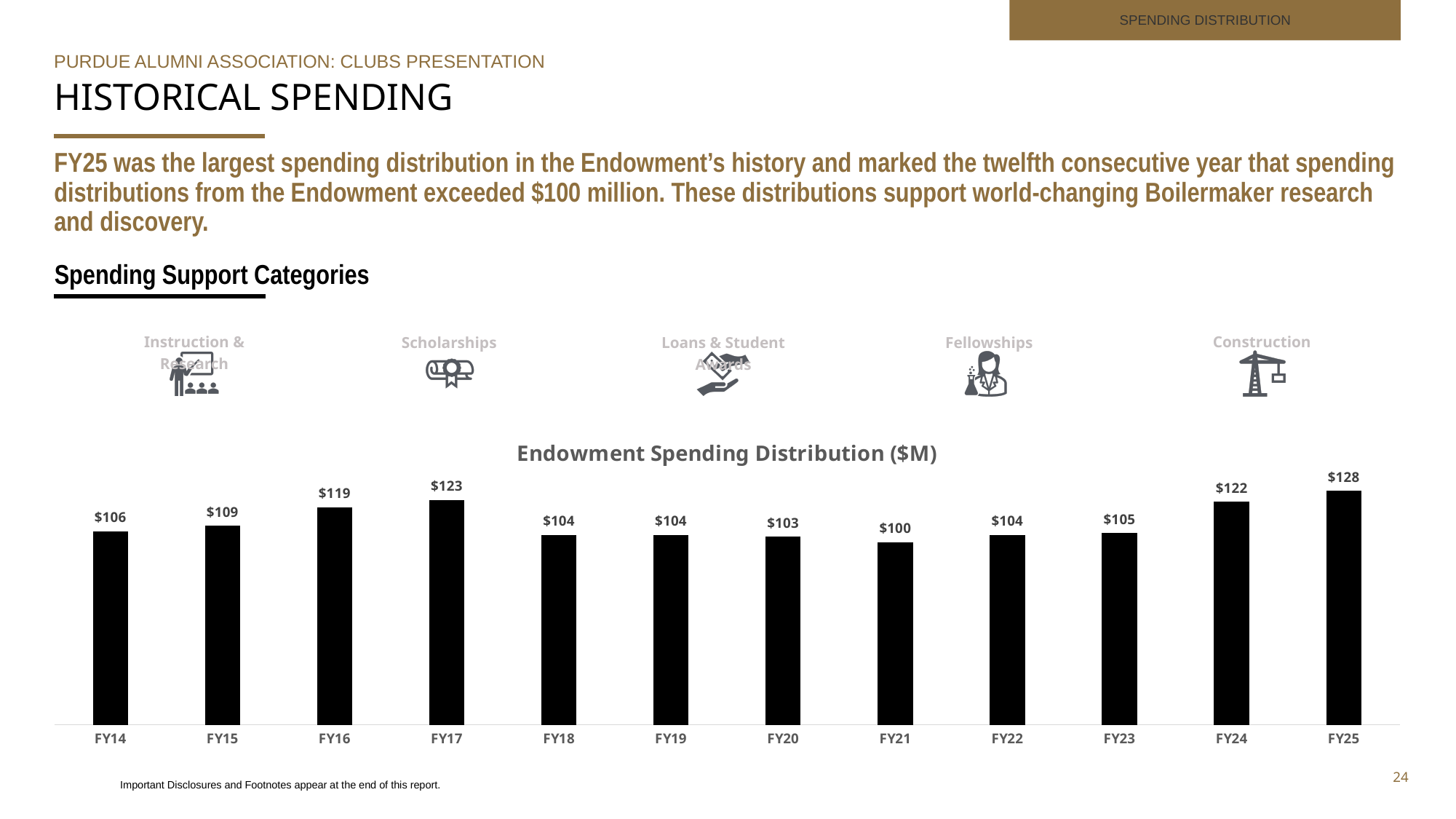
What is the endowment spending distribution for FY21? $100 What is the difference between the FY25 and FY24 spending distributions? $6 What kind of chart is used to show the Endowment Spending Distribution? Bar chart Which is larger, the spending distribution for FY16 or for FY23? FY16 Do the spending distribution values rise or fall from FY21 to FY25? Rise What is the difference between the FY17 and FY21 spending distributions? $23 What is the endowment spending distribution for FY17? $123 How many fiscal years are shown on the x axis of the chart? 12 What is the endowment spending distribution for FY14? $106 Which fiscal year has the highest endowment spending distribution? FY25 What is the title of the chart? Endowment Spending Distribution ($M) Which fiscal year has the lowest endowment spending distribution? FY21